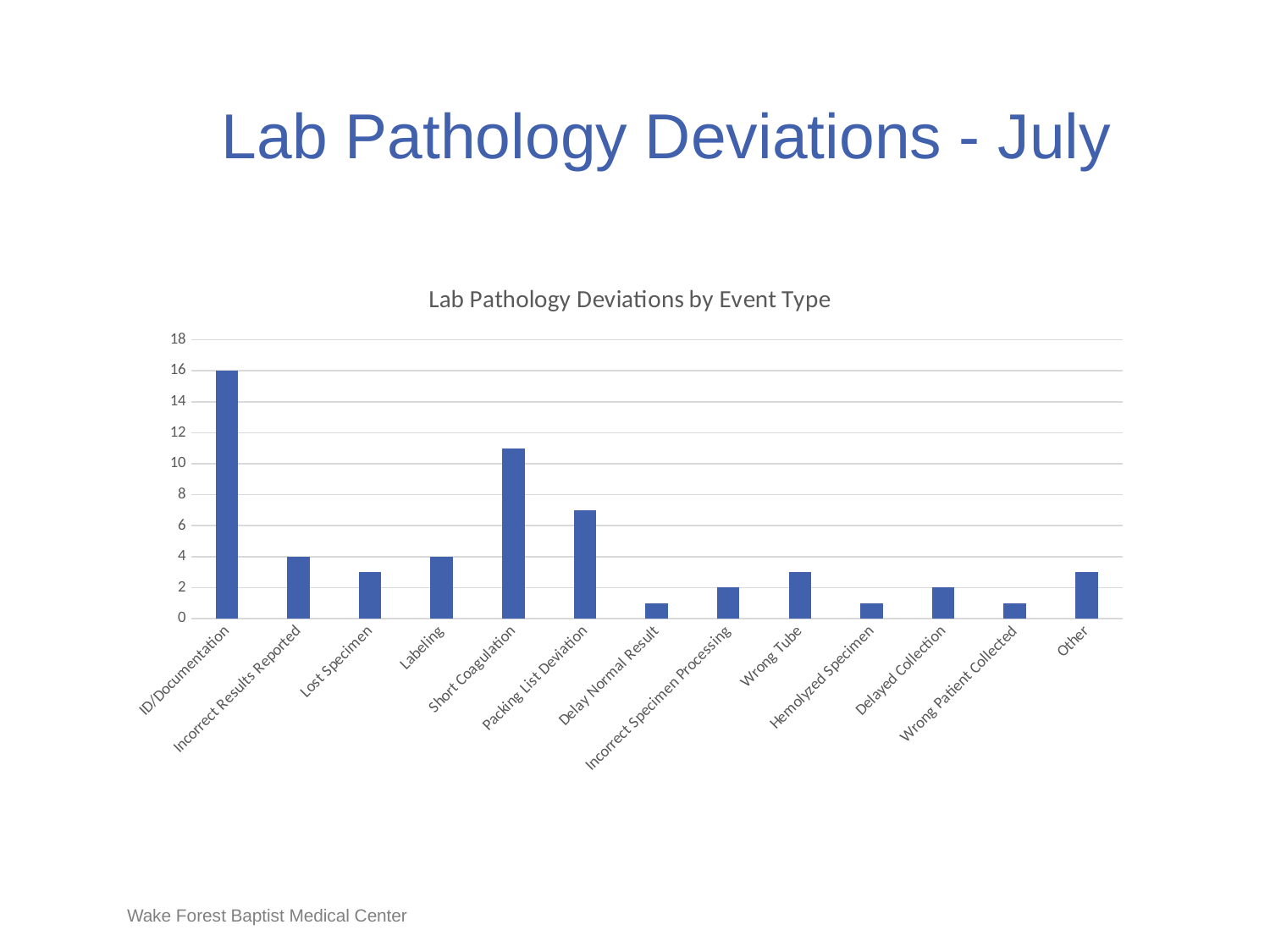
What is the value for Labeling? 4 Which is larger, the value for Short Coagulation or the value for Packing List Deviation? Short Coagulation What is the value for Delayed Collection? 2 Is the value for Short Coagulation greater or less than 10? greater Which event type has the highest number of deviations? ID/Documentation What type of chart is shown on the slide? bar chart What is the value for Incorrect Results Reported? 4 What is the title of the chart? Lab Pathology Deviations by Event Type Is the value for Packing List Deviation greater or less than 8? less How many event type categories are shown on the x axis? 13 What is the difference between the values for ID/Documentation and Labeling? 12 What is the value for ID/Documentation? 16